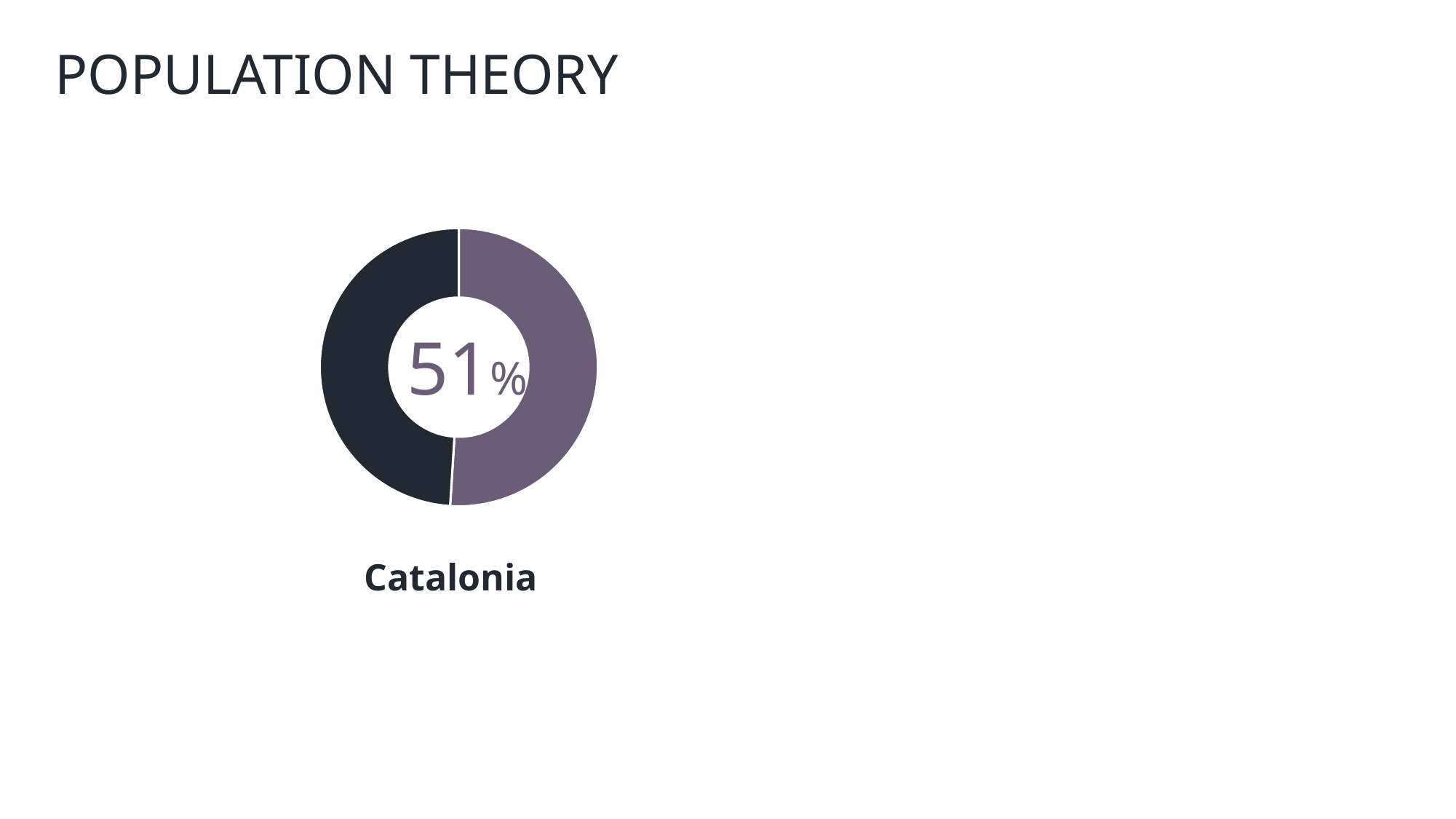
Is the purple slice of the donut chart greater or less than 50%? greater What is the title of the slide containing the donut chart? POPULATION THEORY What is the value shown for Catalonia in the donut chart? 51% Which slice of the donut chart is larger, the purple one or the dark one? the purple one What label appears below the donut chart? Catalonia What kind of chart is shown on the slide? donut chart What percentage is printed in the centre of the donut chart? 51% How many slices does the donut chart have? 2